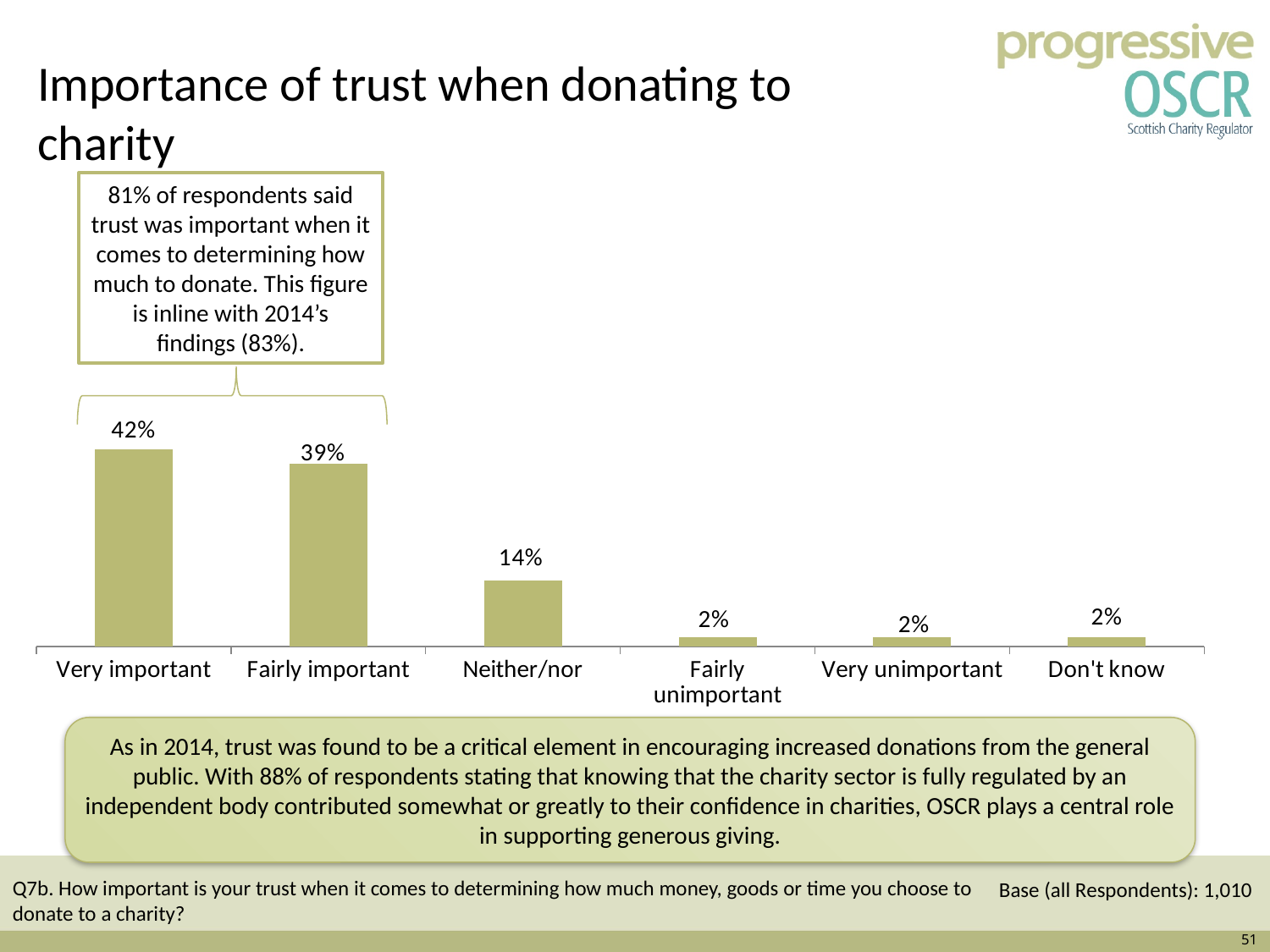
What is the difference between the 'Fairly important' and 'Neither/nor' values? 25% What percentage of respondents said trust was 'Very important' when donating to charity? 42% What is the base (number of respondents) stated for the chart? 1,010 Which is larger, the value for 'Neither/nor' or the value for 'Fairly unimportant'? Neither/nor Which category has the highest value in the chart? Very important What is the value shown for 'Fairly important'? 39% What kind of chart is shown on the slide? Bar chart What is the difference between the 'Very important' and 'Fairly important' values? 3% Do the values generally rise or fall moving from 'Very important' to 'Very unimportant' along the x axis? Fall How many categories are shown on the x axis of the chart? 6 What is the value shown for 'Neither/nor'? 14% What is the value shown for 'Don't know'? 2%